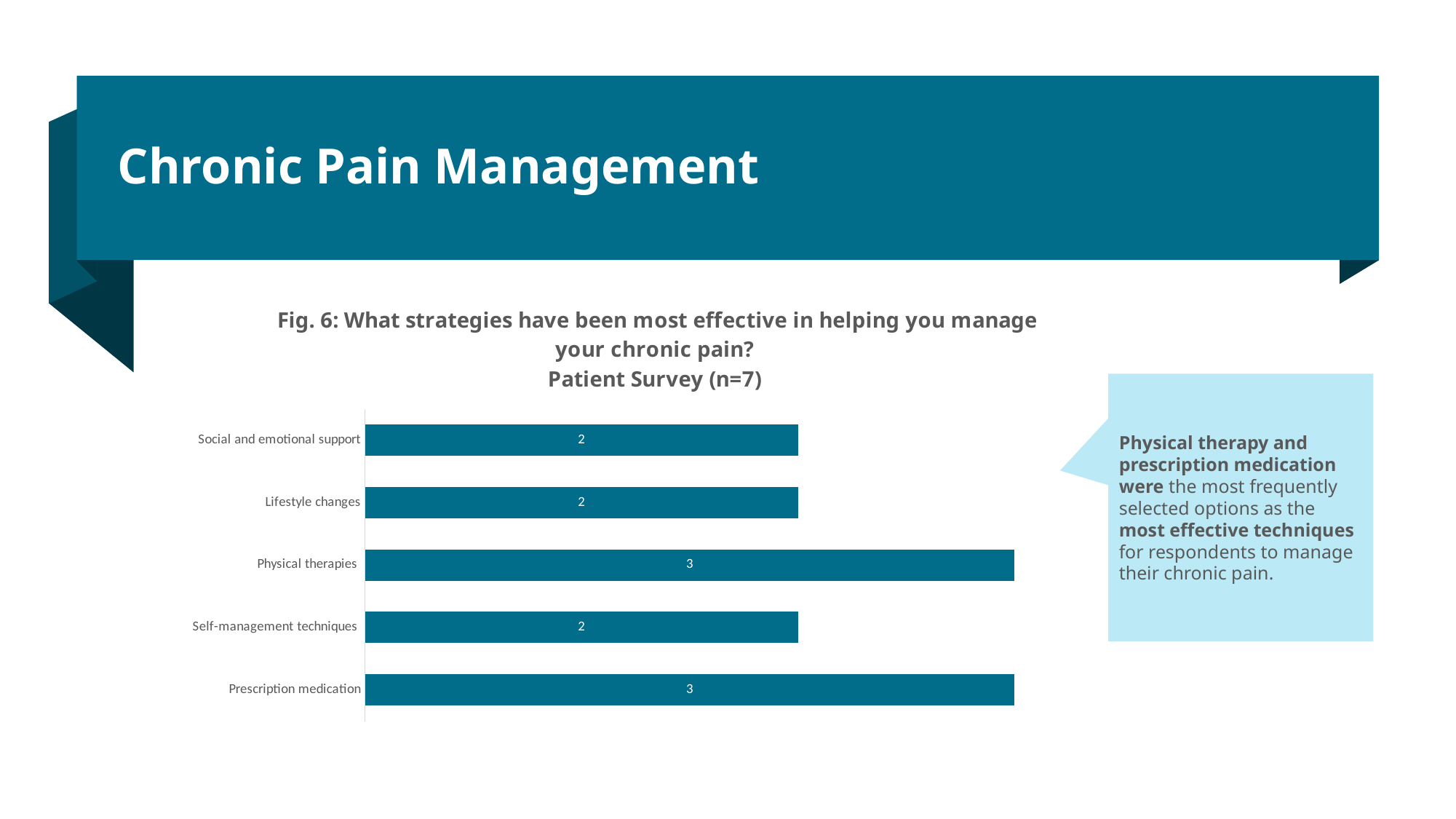
What figure number is given in the chart title? Fig. 6 What is the sample size (n) stated in the chart title? 7 Which is larger, the value for Prescription medication or the value for Self-management techniques? Prescription medication What is the value for Social and emotional support? 2 What is the total of all the values shown in the chart? 12 How many categories are shown in the chart? 5 What is the difference between the values for Physical therapies and Lifestyle changes? 1 What is the value for Physical therapies? 3 What is the value for Lifestyle changes? 2 What is the value for Self-management techniques? 2 What kind of chart is shown on the slide? Bar chart What is the value for Prescription medication? 3